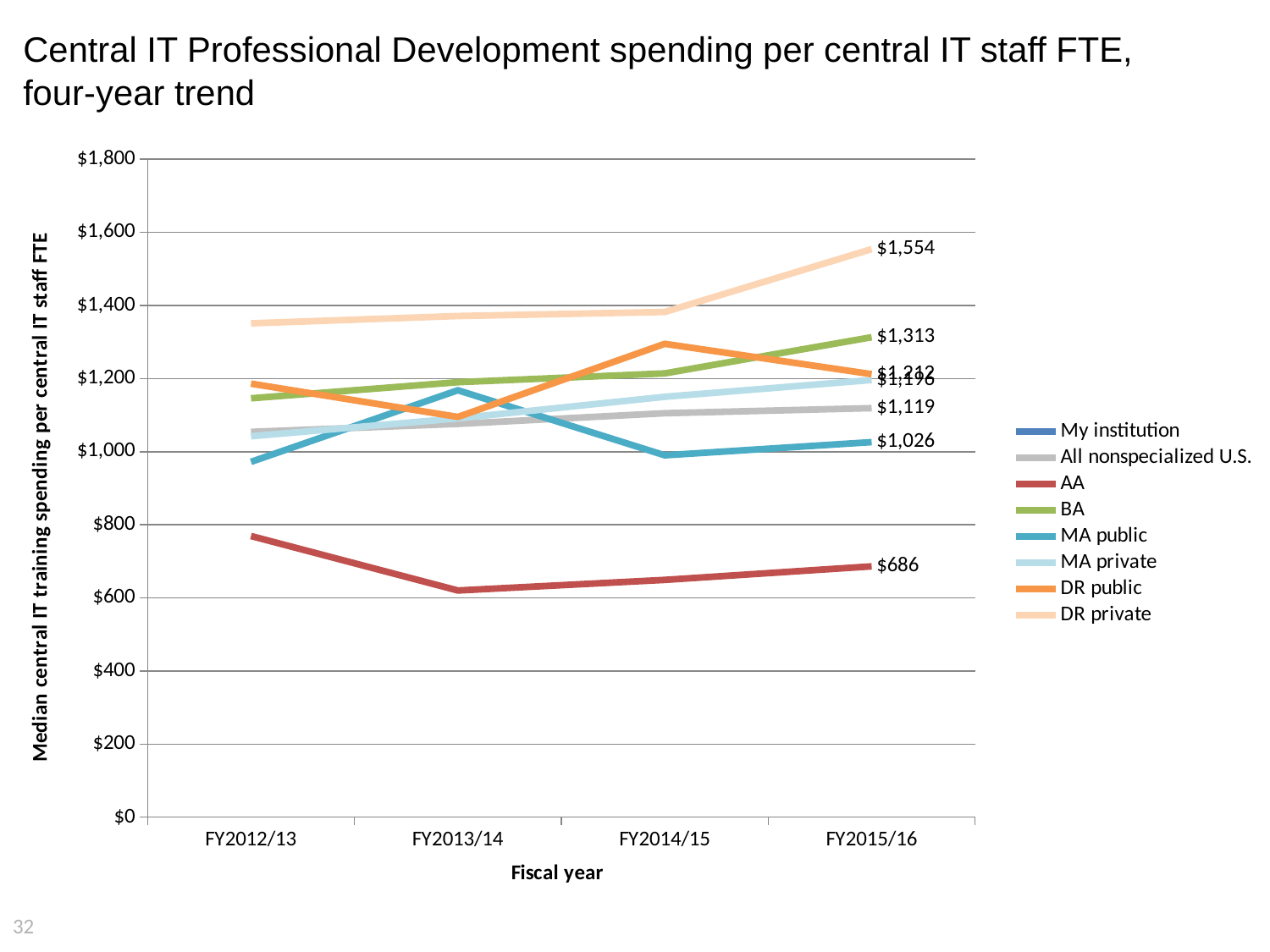
What is the value for BA in FY2015/16? $1,313 Is the value for AA in FY2013/14 greater or less than $800? less How many fiscal years are shown on the x axis? 4 Does the DR private line rise or fall from FY2012/13 to FY2015/16? rise How many series does the legend list? 8 What is the value for MA public in FY2015/16? $1,026 What kind of chart is shown on the slide? line chart What is the value for DR private in FY2015/16? $1,554 Which series has the lowest value in FY2015/16? AA What is the difference between the DR private and BA values in FY2015/16? $241 What is the value for AA in FY2015/16? $686 Which series has the highest value in FY2015/16? DR private